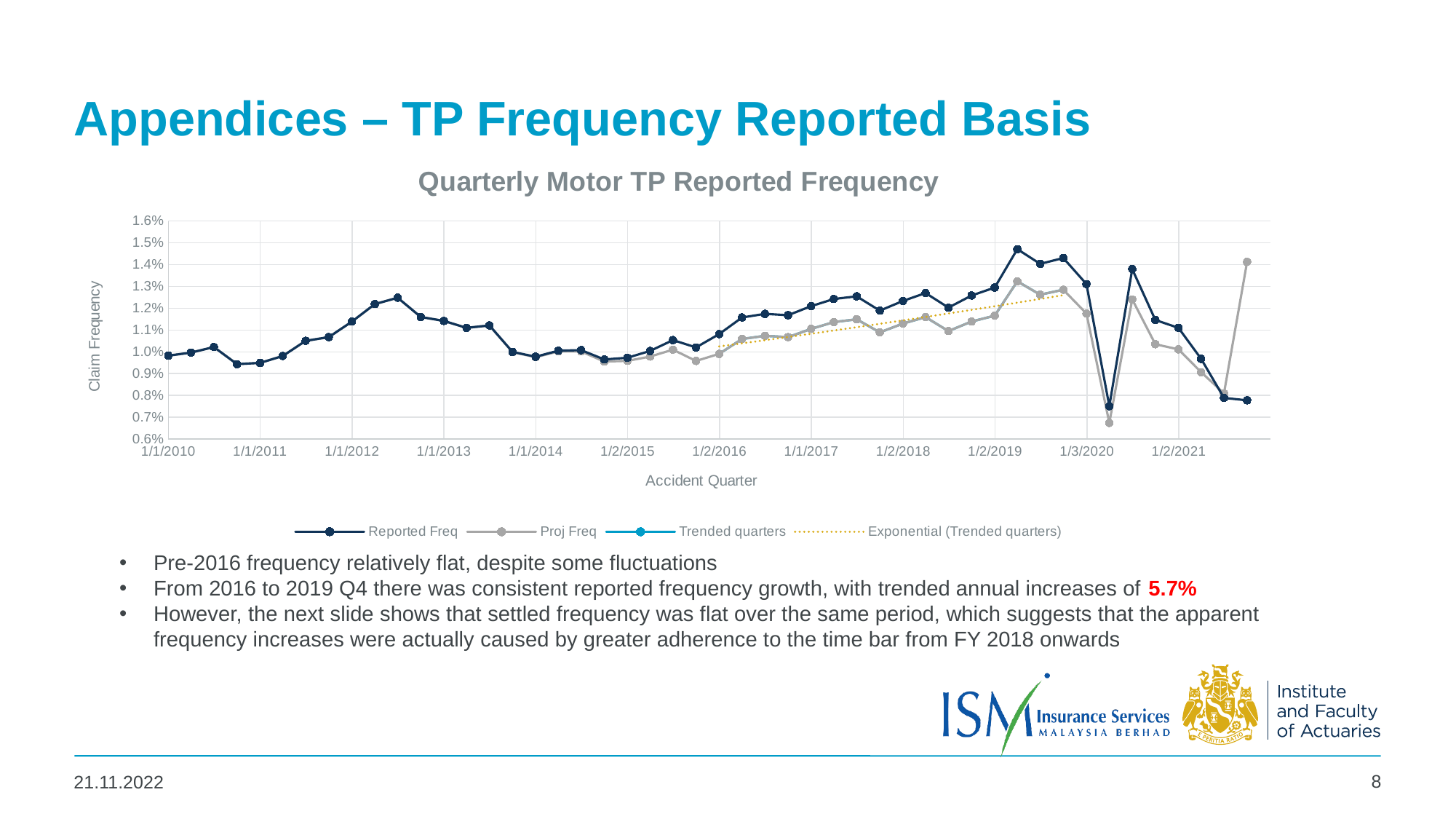
Does the Reported Freq series generally rise or fall between 1/2/2016 and 1/2/2019? rise Is the Reported Freq value at 1/1/2012 greater or less than 1.0%? greater Is the Reported Freq value at 1/1/2017 greater or less than 1.0%? greater Is the lowest value of the Proj Freq series greater or less than 0.8%? less At the last plotted quarter on the chart, which series has the larger value, Reported Freq or Proj Freq? Proj Freq What is the title of the chart? Quarterly Motor TP Reported Frequency What kind of chart is shown on the slide? Line chart How many series does the chart legend list? 4 What is the label on the vertical axis of the chart? Claim Frequency